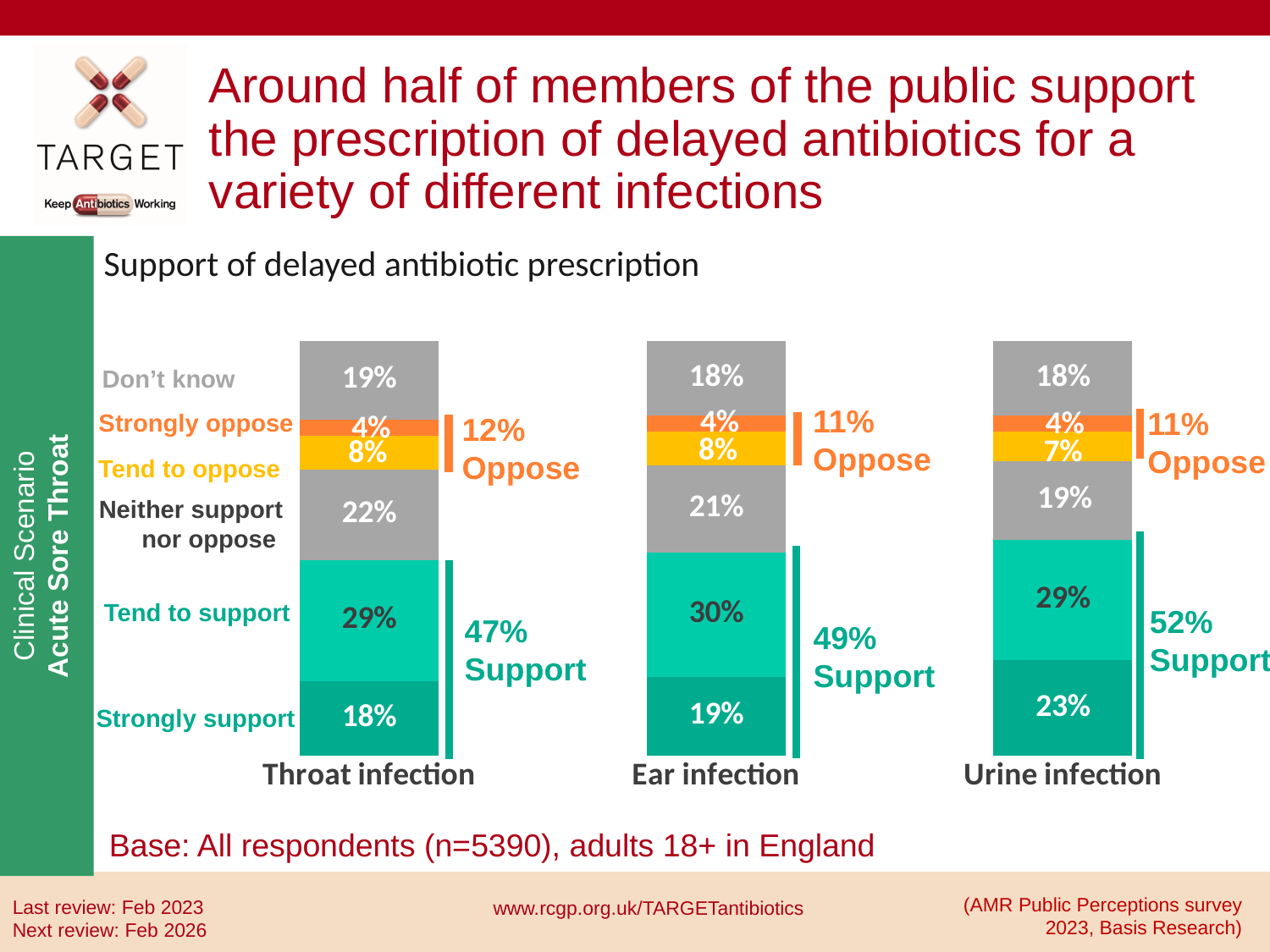
What percentage of respondents 'Tend to support' delayed antibiotic prescription for a throat infection? 29% Which infection has the highest combined 'Oppose' percentage? Throat infection What is the difference between the 'Strongly support' percentages for urine infection and throat infection? 5% Is the 'Tend to support' percentage larger for ear infection or throat infection? Ear infection What is the 'Don't know' percentage for ear infection? 18% What percentage of respondents 'Strongly support' delayed antibiotic prescription for a urine infection? 23% What is the title of the chart? Support of delayed antibiotic prescription How many infection types are shown on the x axis of the chart? 3 What type of chart is shown on the slide? Stacked bar chart How many response categories are listed down the left side of the chart? 6 Which infection has the highest combined 'Support' percentage? Urine infection What is the combined 'Support' percentage shown for ear infection? 49%